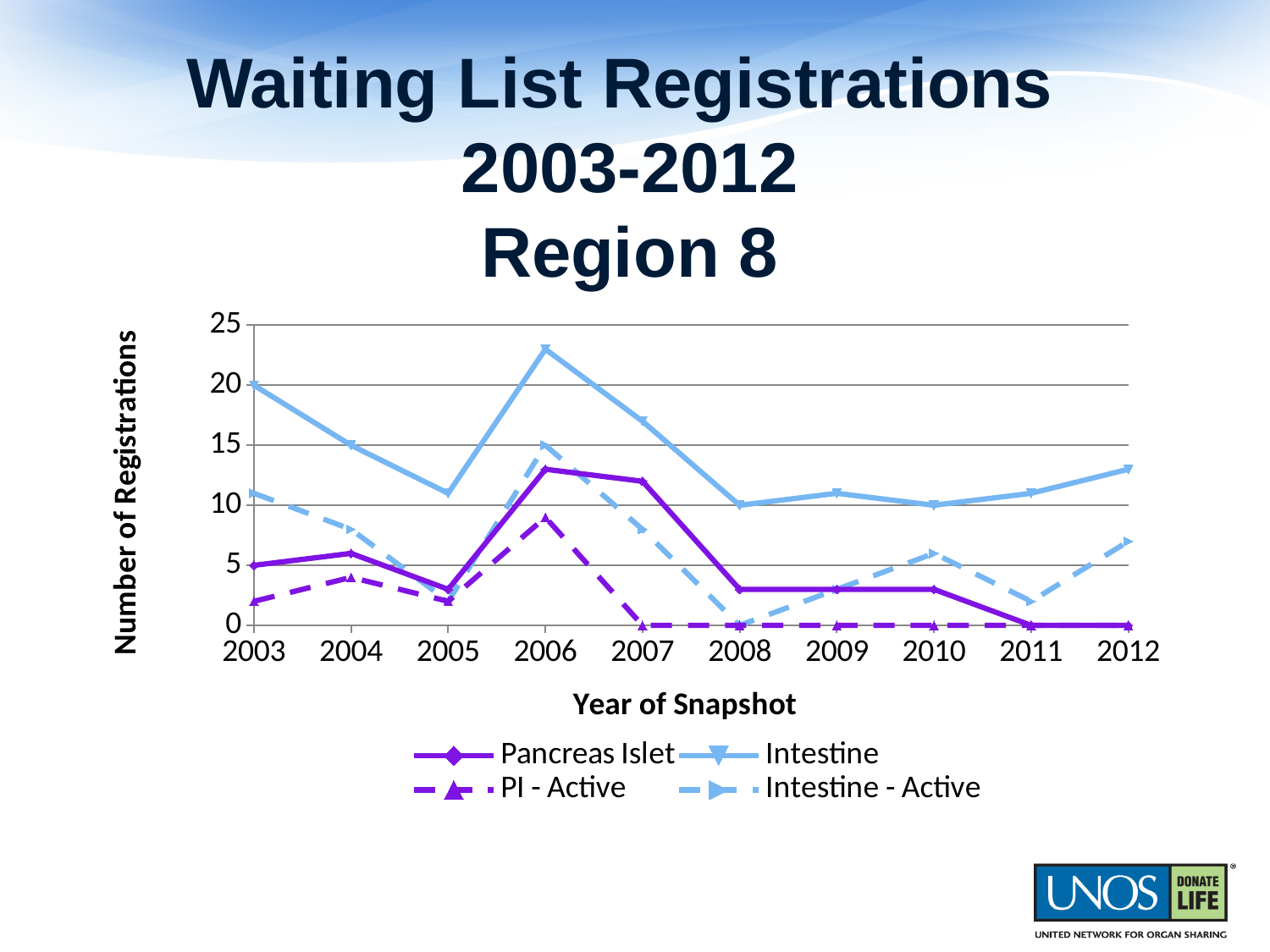
What is the value for Intestine in 2008? 10 How many series does the legend list? 4 In which year does the Intestine series reach its highest value? 2006 Is the value for Intestine in 2006 greater or less than 20? greater What kind of chart is shown on the slide? line chart What is the label of the y axis? Number of Registrations Which series is higher in 2007, Intestine or Pancreas Islet? Intestine What is the value for Pancreas Islet in 2012? 0 What is the value for Intestine in 2004? 15 How many years are shown on the x axis? 10 What is the value for Intestine in 2003? 20 Is the value for Pancreas Islet in 2006 greater or less than 10? greater